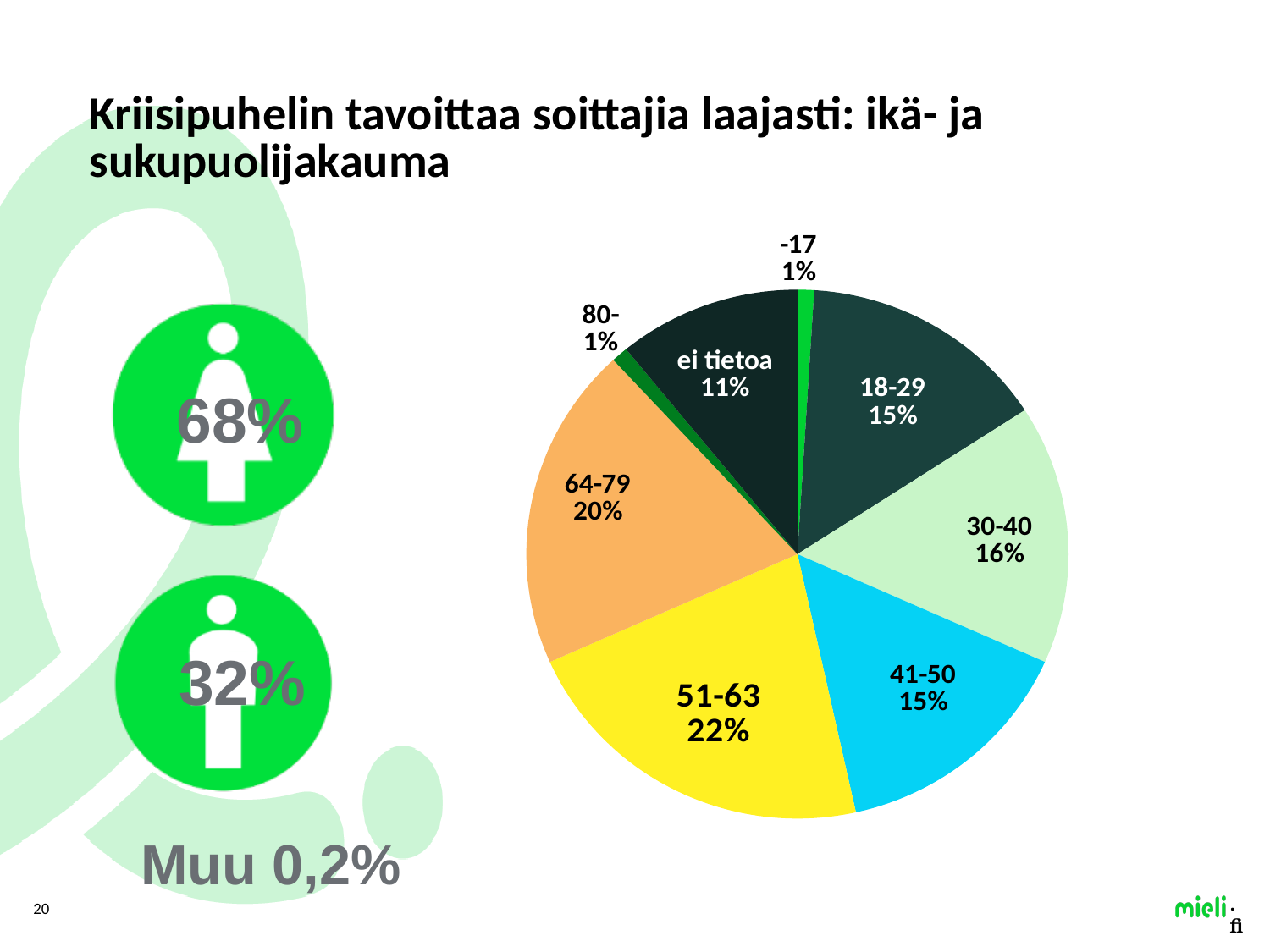
What is the difference between the shares of the 51-63 and 64-79 age groups? 2% What kind of chart is shown on the slide? pie chart What share of callers is in the 30-40 age group? 16% What share of callers is labelled 'ei tietoa'? 11% Which age group has the largest share of the pie? 51-63 What share of callers is in the -17 age group? 1% Which has a larger share, the 30-40 group or the 41-50 group? 30-40 What colour is the 51-63 slice of the pie chart? yellow How many slices does the pie chart have? 8 What share of callers is in the 64-79 age group? 20% What share of callers is in the 51-63 age group? 22% What is the combined share of the 18-29 and 30-40 age groups? 31%